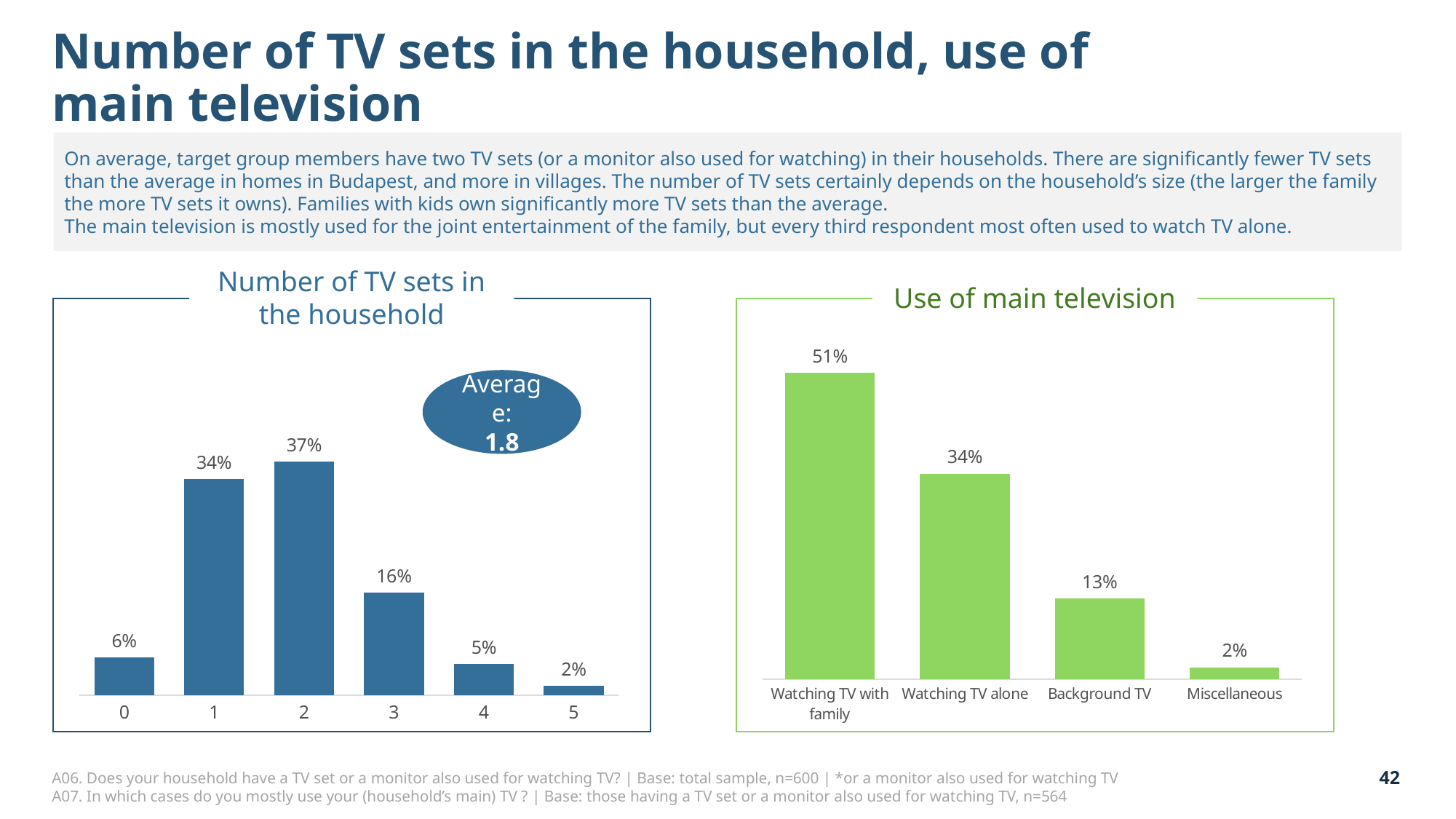
In the 'Number of TV sets in the household' chart, how many categories are shown on the x axis? 6 In the 'Use of main television' chart, what percentage is shown for 'Watching TV alone'? 34% In the 'Use of main television' chart, which category has the highest value? Watching TV with family What type of chart is the 'Use of main television' chart? Bar chart In the 'Number of TV sets in the household' chart, what is the difference between the percentages for 1 TV set and 3 TV sets? 18 percentage points In the 'Use of main television' chart, what is the difference between 'Watching TV with family' and 'Miscellaneous'? 49 percentage points In the 'Number of TV sets in the household' chart, what average value is shown in the circle? 1.8 In the 'Number of TV sets in the household' chart, which number of TV sets has the highest percentage? 2 In the 'Number of TV sets in the household' chart, what percentage of households have 0 TV sets? 6% In the 'Number of TV sets in the household' chart, what percentage of households have 2 TV sets? 37% In the 'Use of main television' chart, what percentage is shown for 'Background TV'? 13% In the 'Number of TV sets in the household' chart, which number of TV sets has the lowest percentage? 5